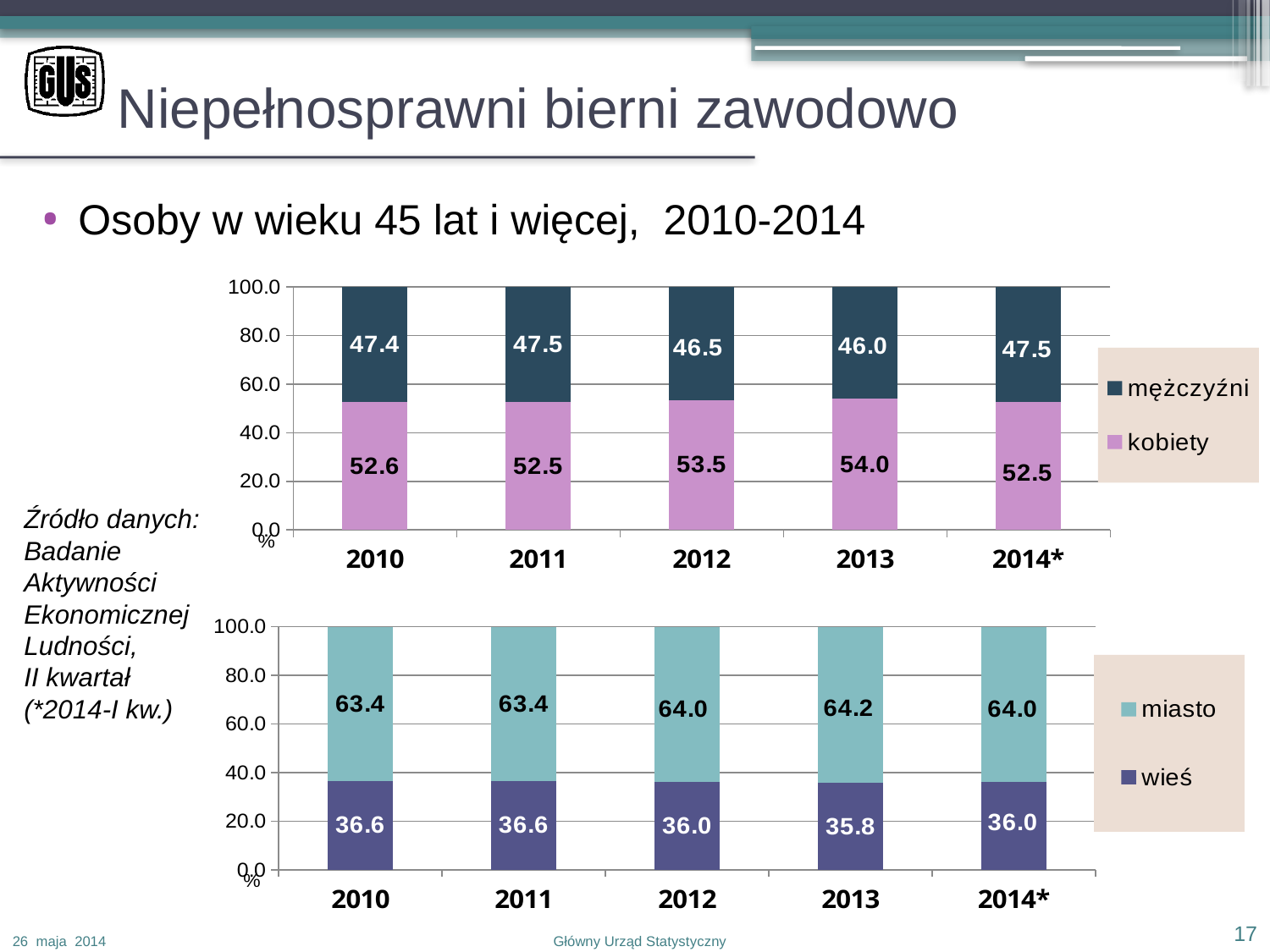
In the bottom chart, what is the value for miasto in 2011? 63.4 What kind of chart is the bottom chart? Stacked bar chart In the top chart, which year has the highest value for kobiety? 2013 In the top chart, what is the value for kobiety in 2013? 54.0 In the bottom chart, which year has the highest value for miasto? 2013 In the top chart, what is the difference between the kobiety and mężczyźni values in 2010? 5.2 In the top chart, what is the value for mężczyźni in 2012? 46.5 In the top chart, which year has the lowest value for mężczyźni? 2013 In the bottom chart, what is the total of the stacked bar for 2012? 100.0 In the top chart, how many series does the legend list? 2 In the bottom chart, what is the value for wieś in 2013? 35.8 In the bottom chart, how many years are shown on the x axis? 5